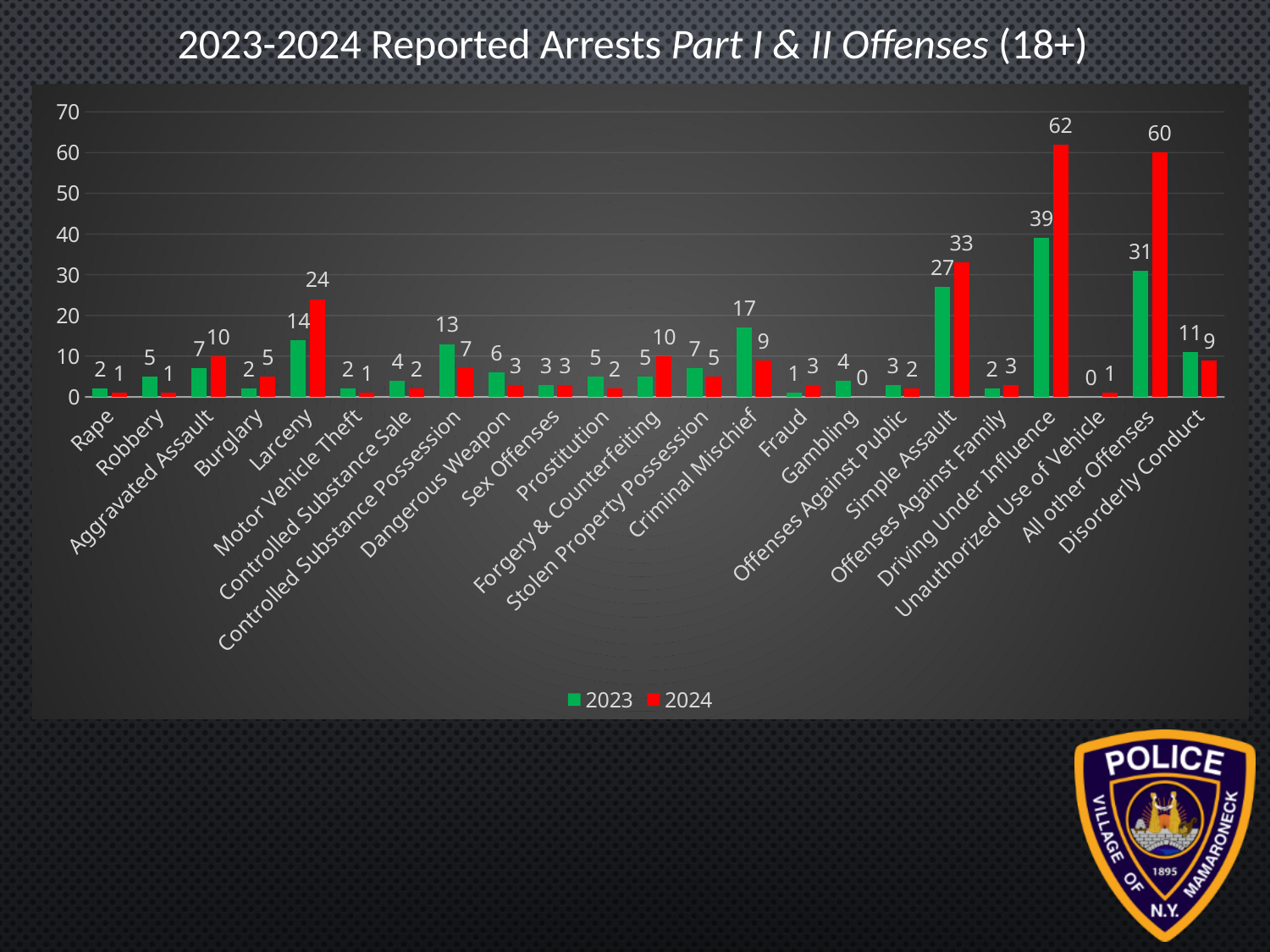
What kind of chart is shown on the slide? Bar chart What is the difference between the 2024 and 2023 values for All other Offenses? 29 How many offense categories are shown on the x axis? 23 Which is larger for Controlled Substance Possession, the 2023 value or the 2024 value? 2023 Which category has the highest 2024 value? Driving Under Influence What is the difference between the 2024 and 2023 values for Driving Under Influence? 23 What is the 2024 value for Larceny? 24 What is the 2023 value for Criminal Mischief? 17 Which category has the lowest 2023 value? Unauthorized Use of Vehicle How many series does the legend list? 2 What is the 2023 value for Driving Under Influence? 39 Which is larger for Simple Assault, the 2023 value or the 2024 value? 2024